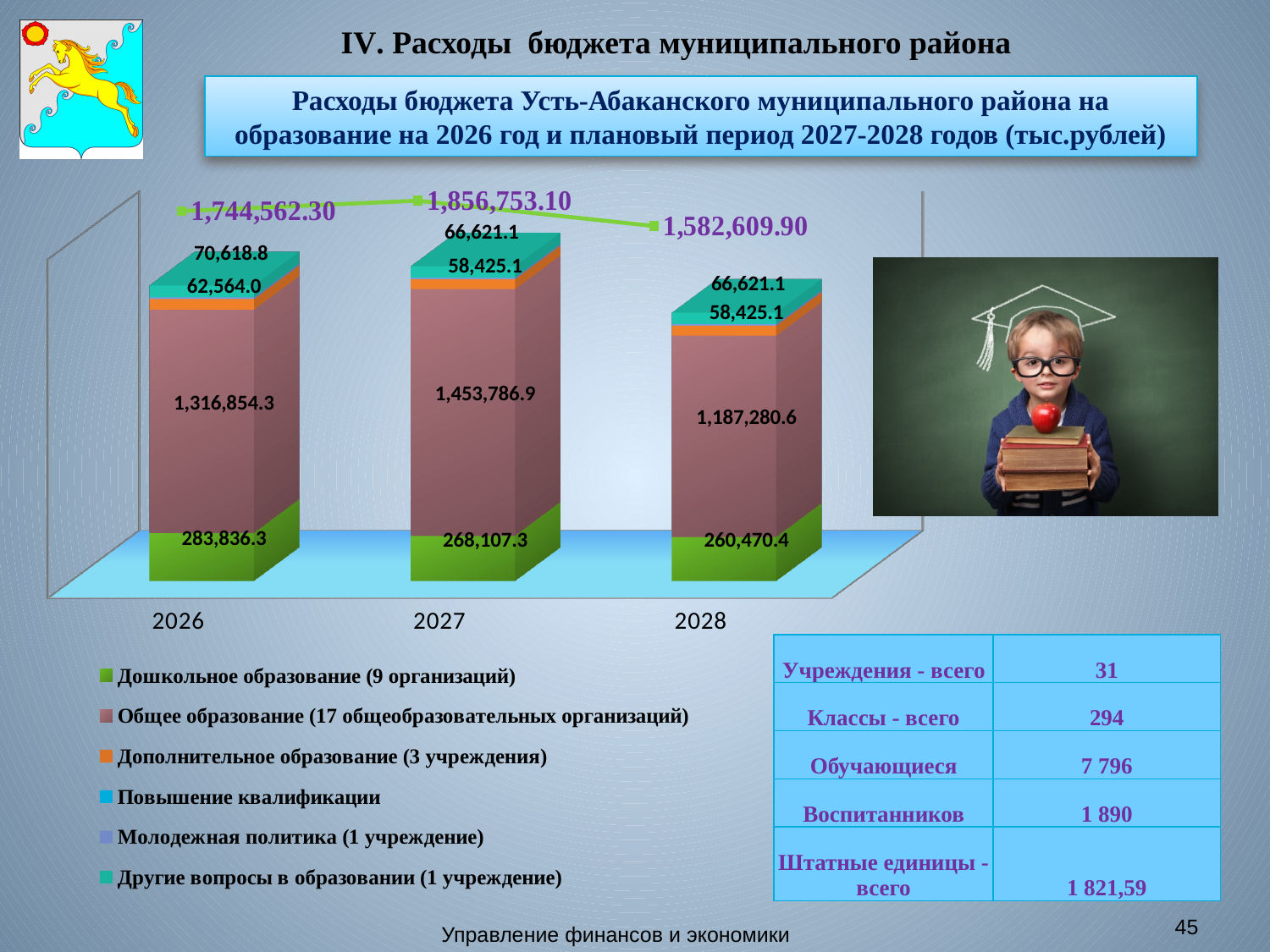
Which is larger: Дошкольное образование in 2026 or in 2028? 2026 By how much does Общее образование in 2027 exceed Общее образование in 2026? 136,932.6 How many series does the chart legend list? 6 What kind of chart is shown on the slide? Stacked bar chart What is the value for Дошкольное образование in 2026? 283,836.3 Which year has the lowest total expenditure? 2028 What is the value for Общее образование in 2027? 1,453,786.9 Which year has the highest total expenditure? 2027 What is the total expenditure shown for 2028? 1,582,609.90 What is the value for Общее образование in 2028? 1,187,280.6 How many years (categories) are shown on the x axis of the chart? 3 Does the value for Дошкольное образование rise or fall from 2026 to 2028? Fall